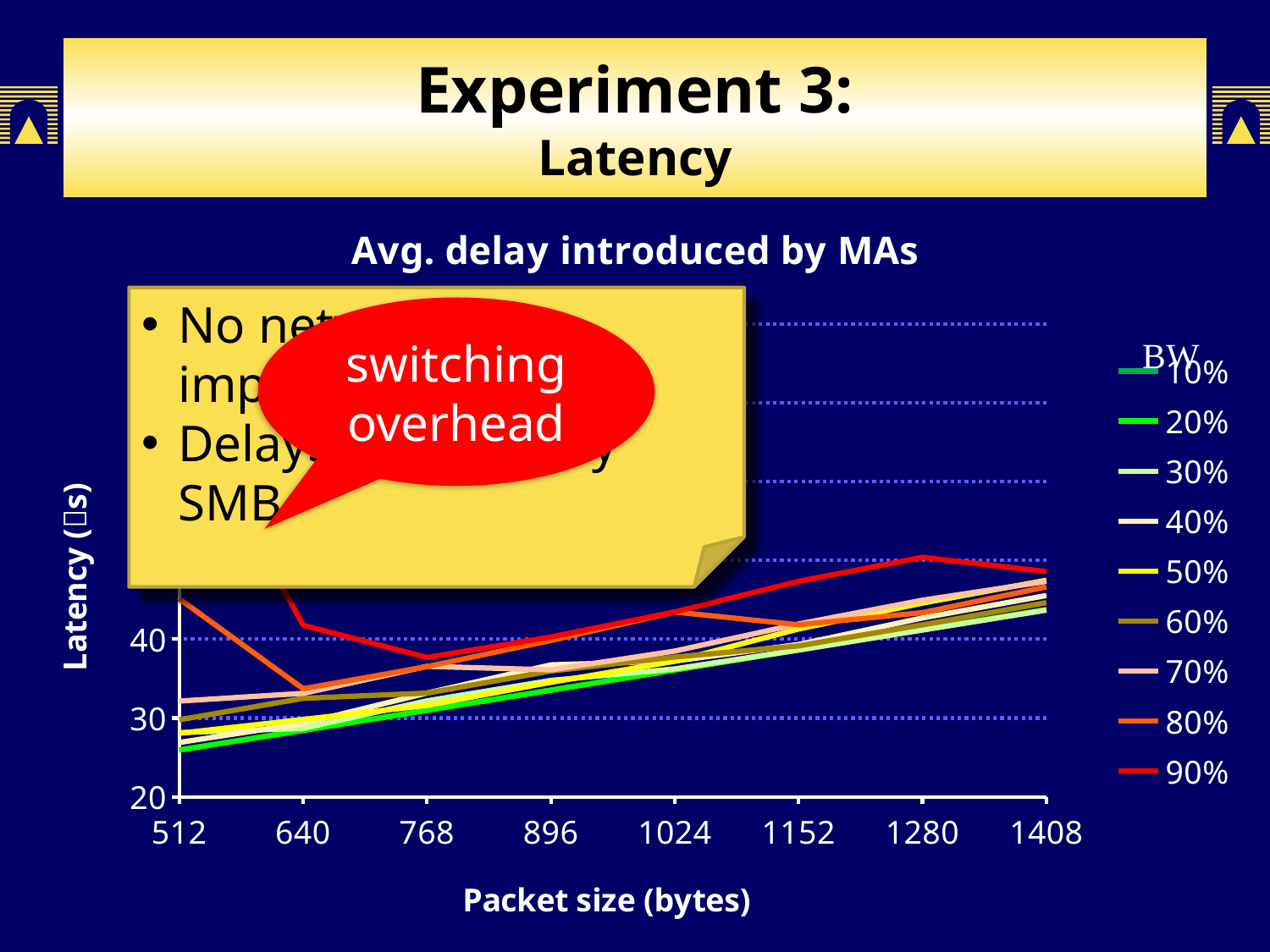
What is the title of the chart? Avg. delay introduced by MAs Is the latency for the 90% BW series at packet size 1408 greater or less than 40? greater Is the latency for the 20% BW series at packet size 512 greater or less than 30? less What kind of chart is shown on the slide? line chart Is the latency for the 20% BW series at packet size 1408 greater or less than 40? greater At packet size 512, which series has the higher latency, 80% BW or 20% BW? 80% Does the latency for the 20% BW series rise or fall as packet size increases from 512 to 1408? rise How many series does the chart's legend list? 9 How many packet sizes are marked along the x axis of the chart? 8 What is the label of the x axis? Packet size (bytes)